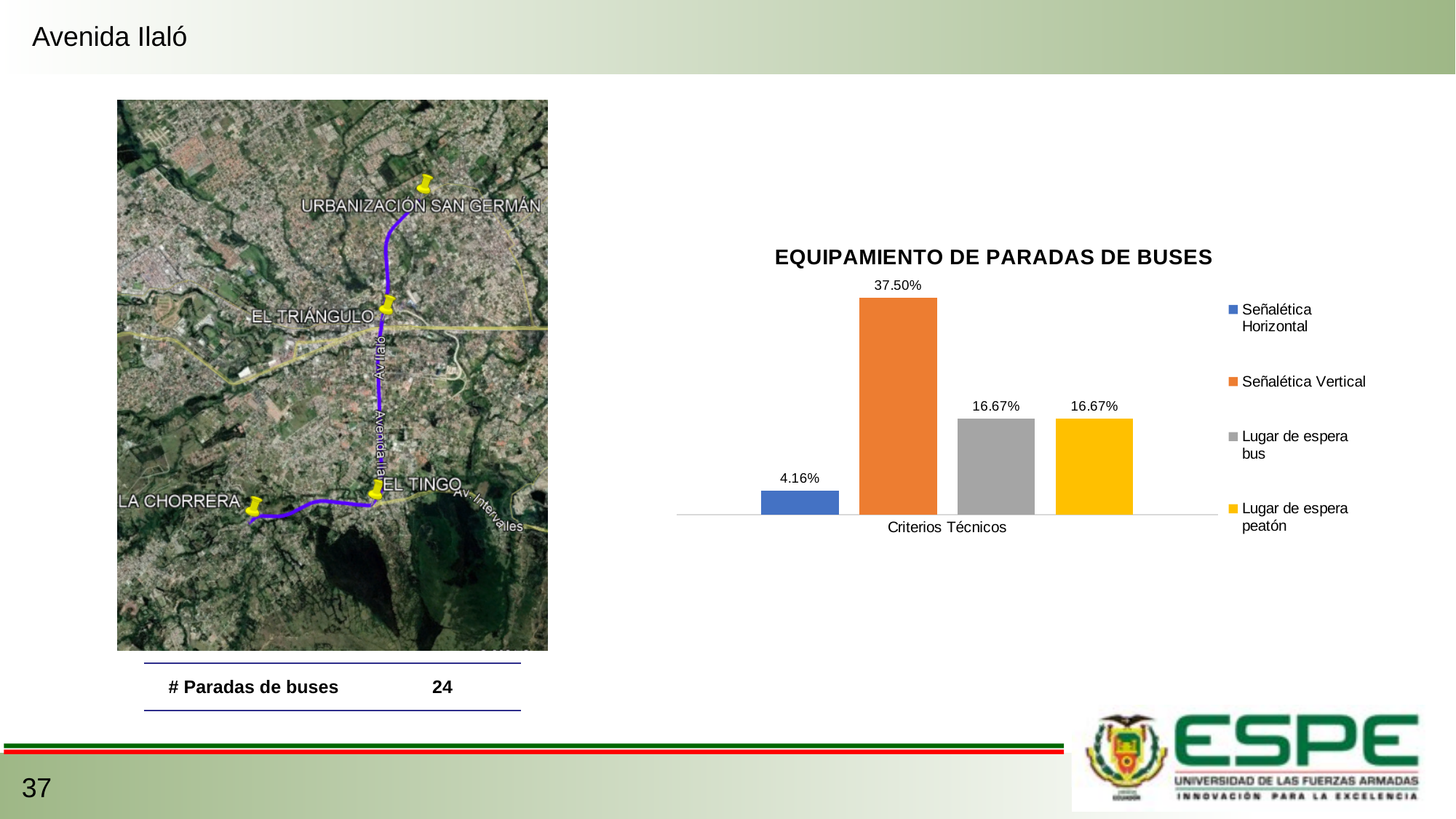
What kind of chart is shown? Bar chart Which is larger, Señalética Vertical or Lugar de espera peatón? Señalética Vertical What is the title of the chart? EQUIPAMIENTO DE PARADAS DE BUSES What is the value for Señalética Vertical? 37.50% What is the value for Señalética Horizontal? 4.16% What is the value for Lugar de espera bus? 16.67% Which series has the highest value? Señalética Vertical What is the difference between Señalética Vertical and Señalética Horizontal? 33.34% What is the difference between Señalética Vertical and Lugar de espera bus? 20.83% How many series does the legend list? 4 What is the value for Lugar de espera peatón? 16.67% Which series has the lowest value? Señalética Horizontal